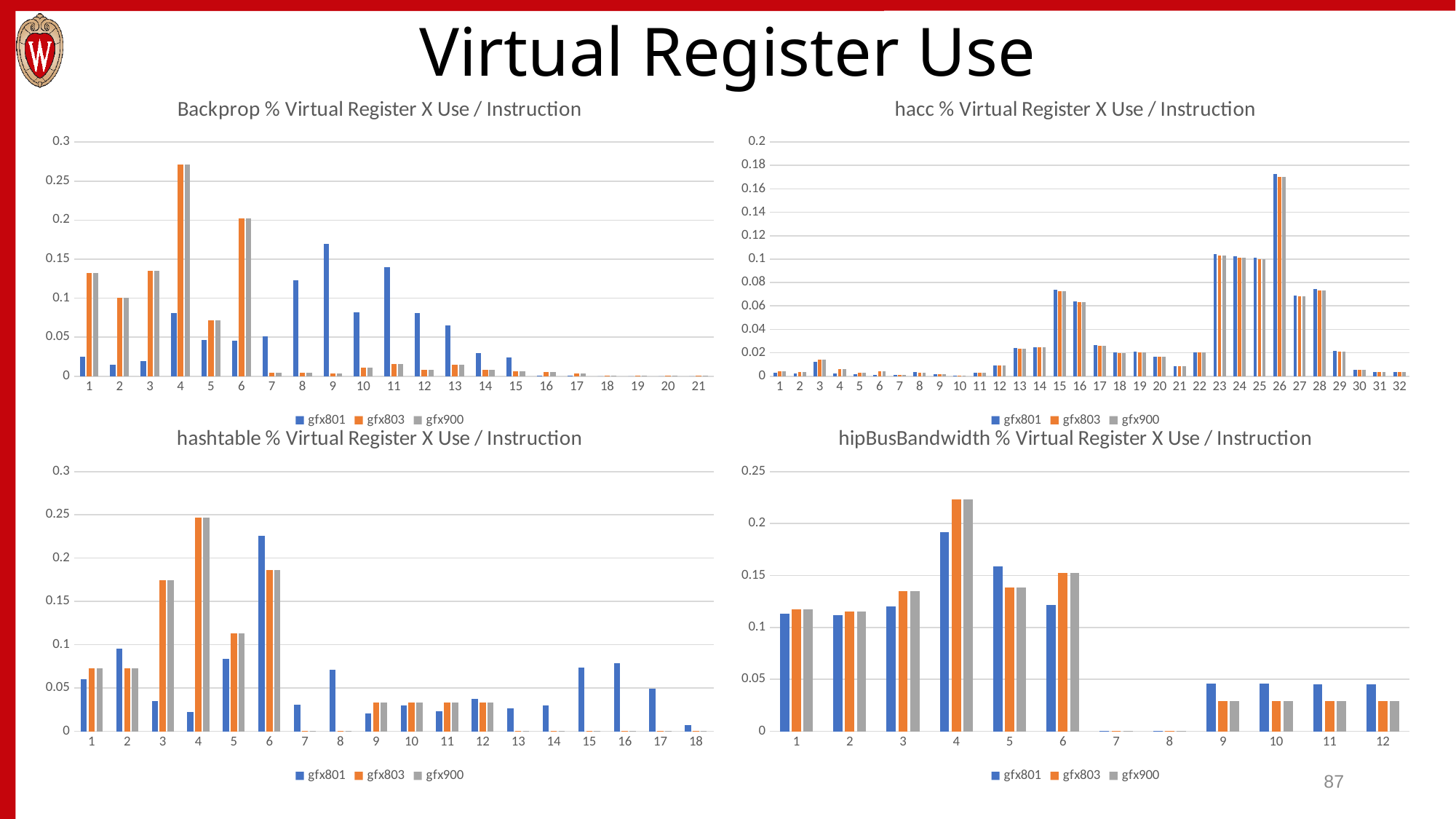
On the hashtable chart, how many categories are shown on the x axis? 18 On the hashtable chart, is the gfx803 value for category 3 greater or less than 0.15? greater On the hashtable chart, which is larger for category 6, gfx801 or gfx803? gfx801 On the Backprop chart, how many series does the legend list? 3 What kind of chart is the hipBusBandwidth chart? bar chart On the Backprop chart, is the gfx803 value for category 4 greater or less than 0.25? greater On the hipBusBandwidth chart, which is larger for category 6, gfx801 or gfx803? gfx803 On the hacc chart, which category has the highest gfx801 value? 26 On the Backprop chart, which category has the highest gfx803 value? 4 On the hacc chart, how many categories are shown on the x axis? 32 On the Backprop chart, is the gfx801 value for category 9 greater or less than 0.15? greater